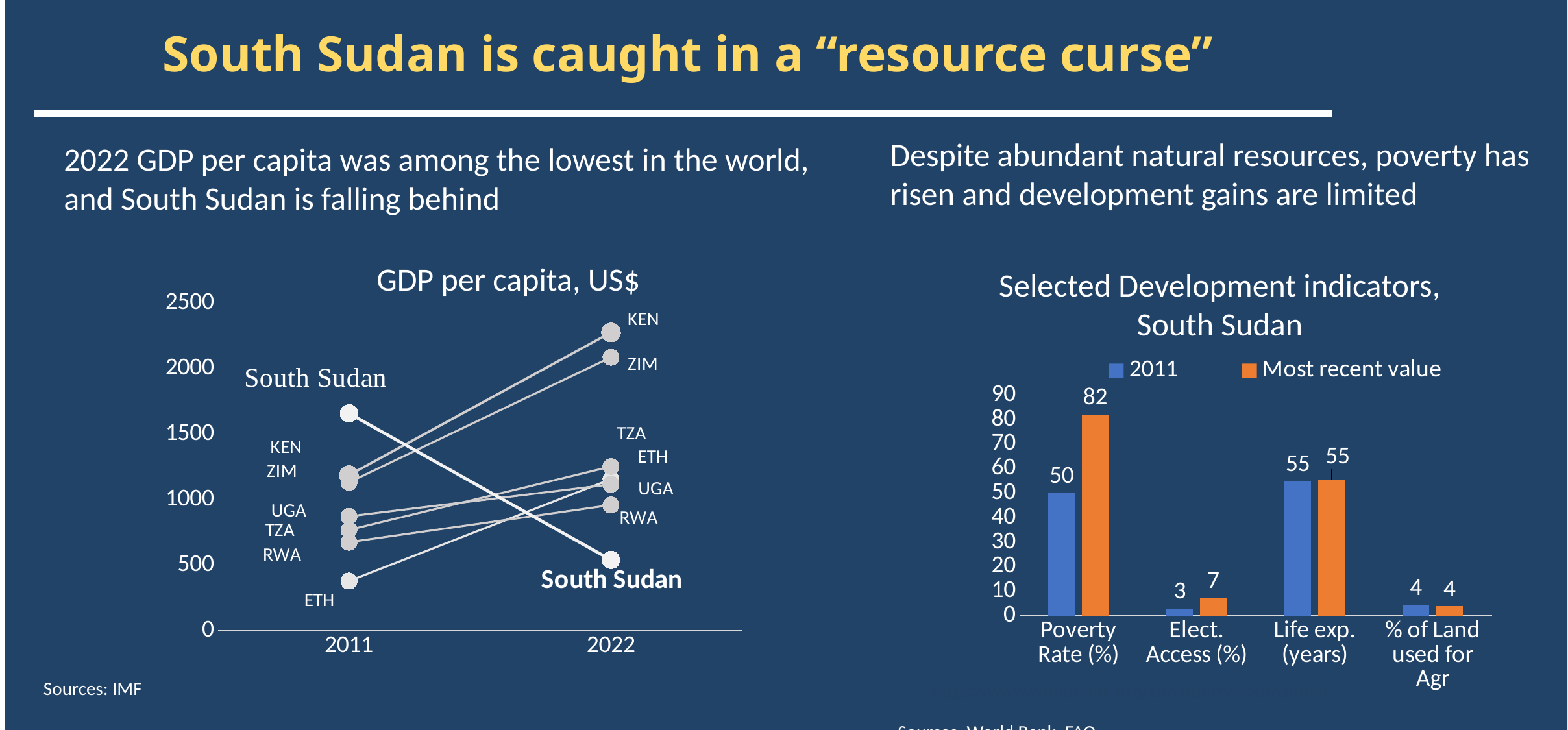
In the 'Selected Development indicators, South Sudan' chart, by how much did the Poverty Rate (%) increase from 2011 to the most recent value? 32 In the 'Selected Development indicators, South Sudan' chart, how many indicator categories are shown on the x axis? 4 In the 'GDP per capita, US$' chart, is South Sudan's 2011 GDP per capita greater or less than 1500? greater In the 'Selected Development indicators, South Sudan' chart, which indicator has the highest most recent value? Poverty Rate (%) In the 'Selected Development indicators, South Sudan' chart, what was the Poverty Rate (%) in 2011? 50 In the 'GDP per capita, US$' chart, which country has the highest GDP per capita in 2022? KEN In the 'Selected Development indicators, South Sudan' chart, what is the most recent value for Elect. Access (%)? 7 In the 'GDP per capita, US$' chart, which country has the lowest GDP per capita in 2022? South Sudan In the 'Selected Development indicators, South Sudan' chart, how many series does the legend list? 2 What kind of chart is 'Selected Development indicators, South Sudan'? Bar chart In the 'GDP per capita, US$' chart, does South Sudan's GDP per capita rise or fall from 2011 to 2022? Fall In the 'Selected Development indicators, South Sudan' chart, what is the Poverty Rate (%) for the most recent value? 82